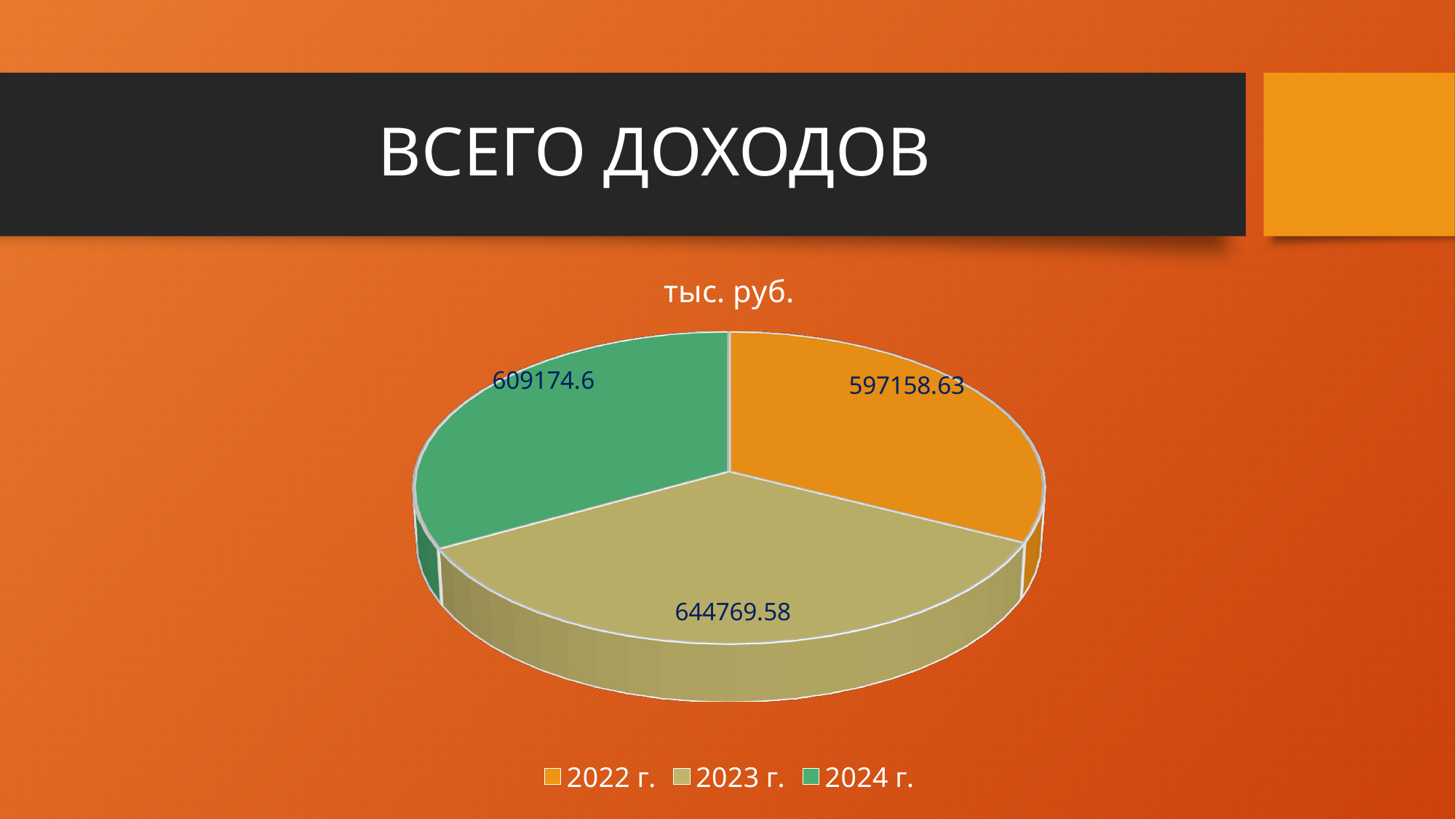
How many entries does the legend list? 3 What is the value for 2022 г. in the pie chart? 597158.63 Which year has the smallest slice in the pie chart? 2022 г. What is the value for 2023 г. in the pie chart? 644769.58 What is the title shown above the pie chart? тыс. руб. How many slices does the pie chart have? 3 What is the difference between the values for 2024 г. and 2022 г.? 12015.97 What is the difference between the values for 2023 г. and 2022 г.? 47610.95 Which is larger, the value for 2024 г. or the value for 2022 г.? 2024 г. What is the value for 2024 г. in the pie chart? 609174.6 What kind of chart is shown on the slide? Pie chart Which year has the largest slice in the pie chart? 2023 г.